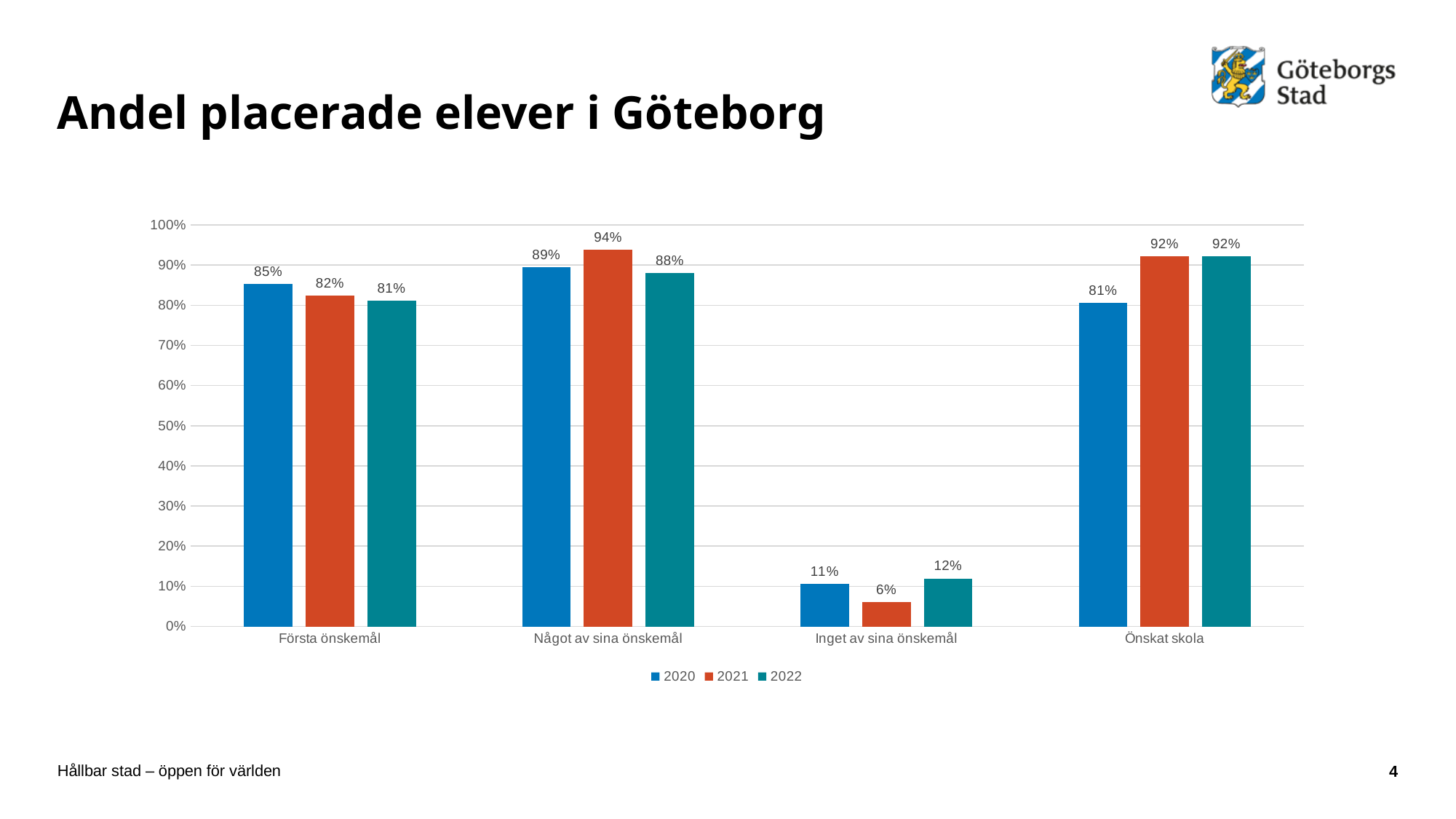
How many categories are shown on the x axis? 4 What is the value for 2021 in the Något av sina önskemål category? 94% What is the title of the slide? Andel placerade elever i Göteborg Which category has the lowest value for 2021? Inget av sina önskemål What kind of chart is shown on the slide? Bar chart Which category has the highest value for 2020? Något av sina önskemål What is the value for 2020 in the Första önskemål category? 85% What is the value for 2022 in the Inget av sina önskemål category? 12% Which is larger in the Första önskemål category, the 2020 value or the 2022 value? 2020 How many series does the legend list? 3 What is the difference between the 2021 and 2020 values in the Något av sina önskemål category? 5% What is the value for 2020 in the Önskat skola category? 81%